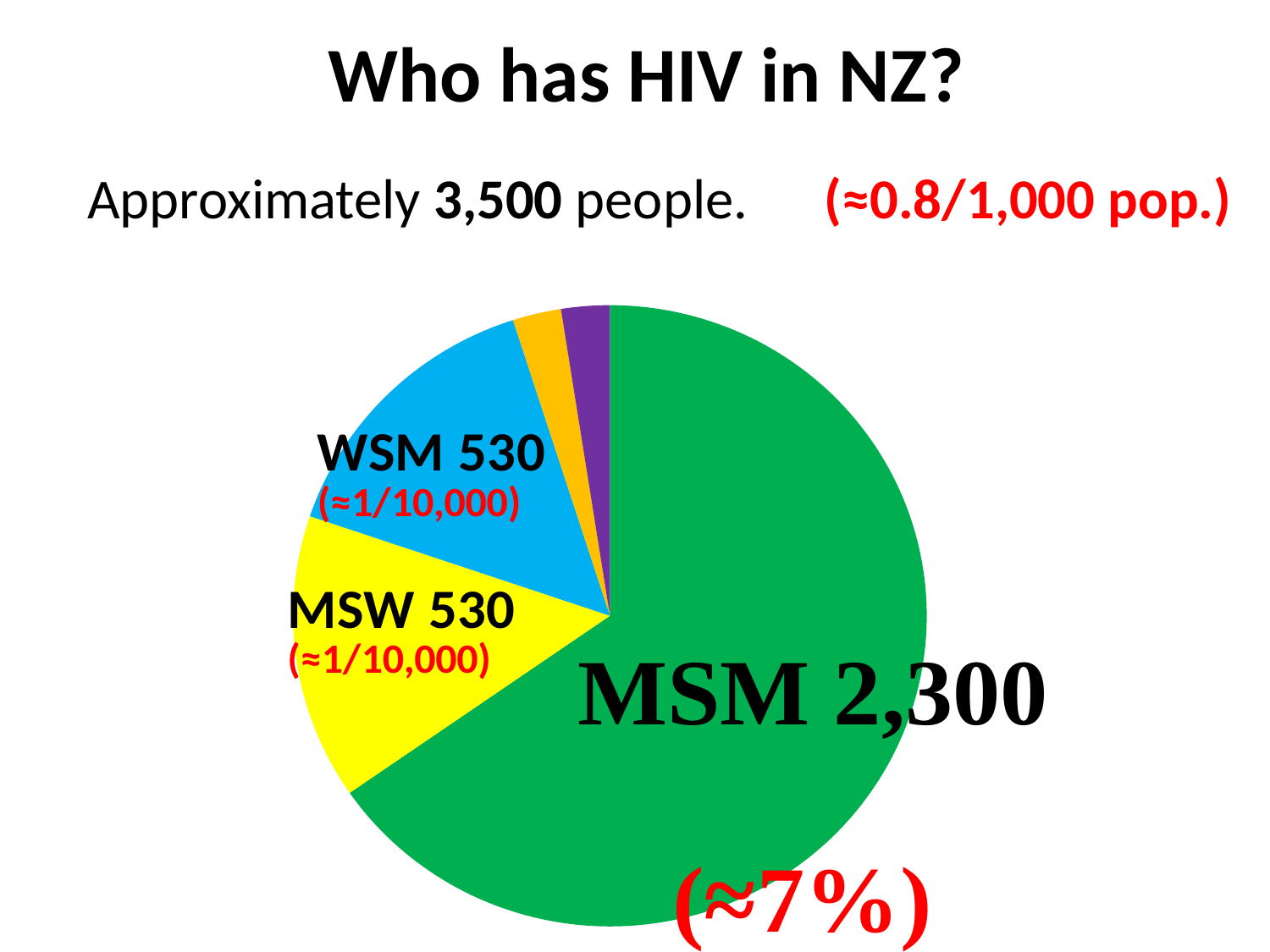
What kind of chart is shown on the slide? Pie chart What is the title of the slide containing the pie chart? Who has HIV in NZ? What colour is the MSM slice of the pie chart? Green What approximate total number of people does the slide state the pie chart represents? 3,500 Which is larger, the MSM slice or the MSW slice? MSM What value is shown for the MSW slice of the pie chart? 530 What value is shown for the WSM slice of the pie chart? 530 What is the difference between the MSM value and the WSM value? 1,770 What value is shown for the MSM slice of the pie chart? 2,300 Which labelled group has the largest slice of the pie chart? MSM How many slices does the pie chart have? 5